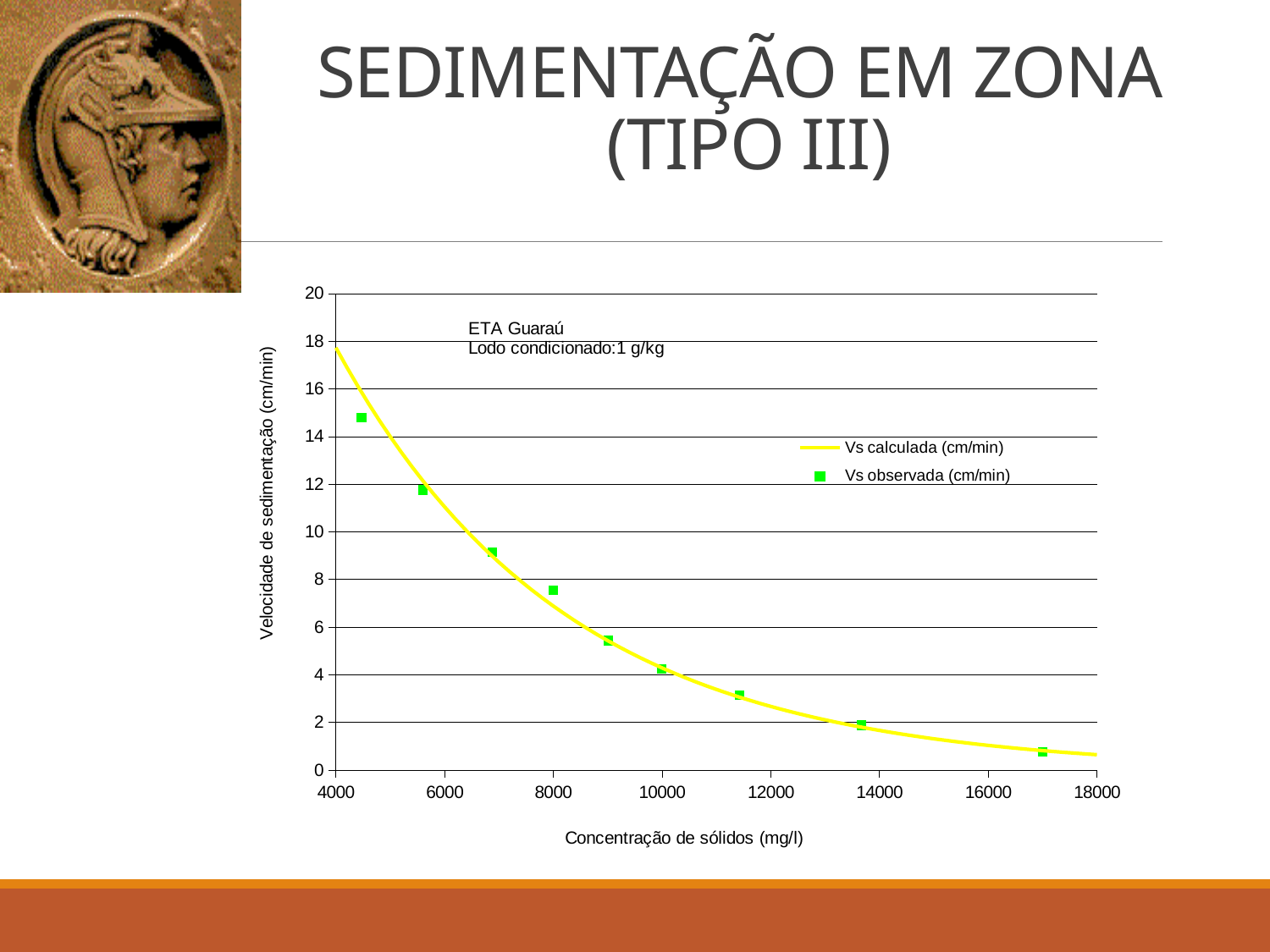
Is the observed velocity at about 17000 mg/l greater or less than 2 cm/min? less Is the observed velocity at about 10000 mg/l greater or less than 6 cm/min? less How many observed data points (green squares) are plotted? 9 Does the sedimentation velocity rise or fall as the solids concentration increases? Fall At which end of the concentration range is the observed sedimentation velocity highest? The lowest concentration (leftmost point, around 4500 mg/l) What are the two series named in the legend? Vs calculada (cm/min) and Vs observada (cm/min) What kind of chart is shown on the slide? Scatter chart with a fitted line Which has the larger observed velocity: the point near 5600 mg/l or the point near 8000 mg/l? The point near 5600 mg/l Is the observed velocity at the lowest plotted concentration (around 4500 mg/l) greater or less than 14 cm/min? greater What is the title of the x axis? Concentração de sólidos (mg/l) How many series does the legend list? 2